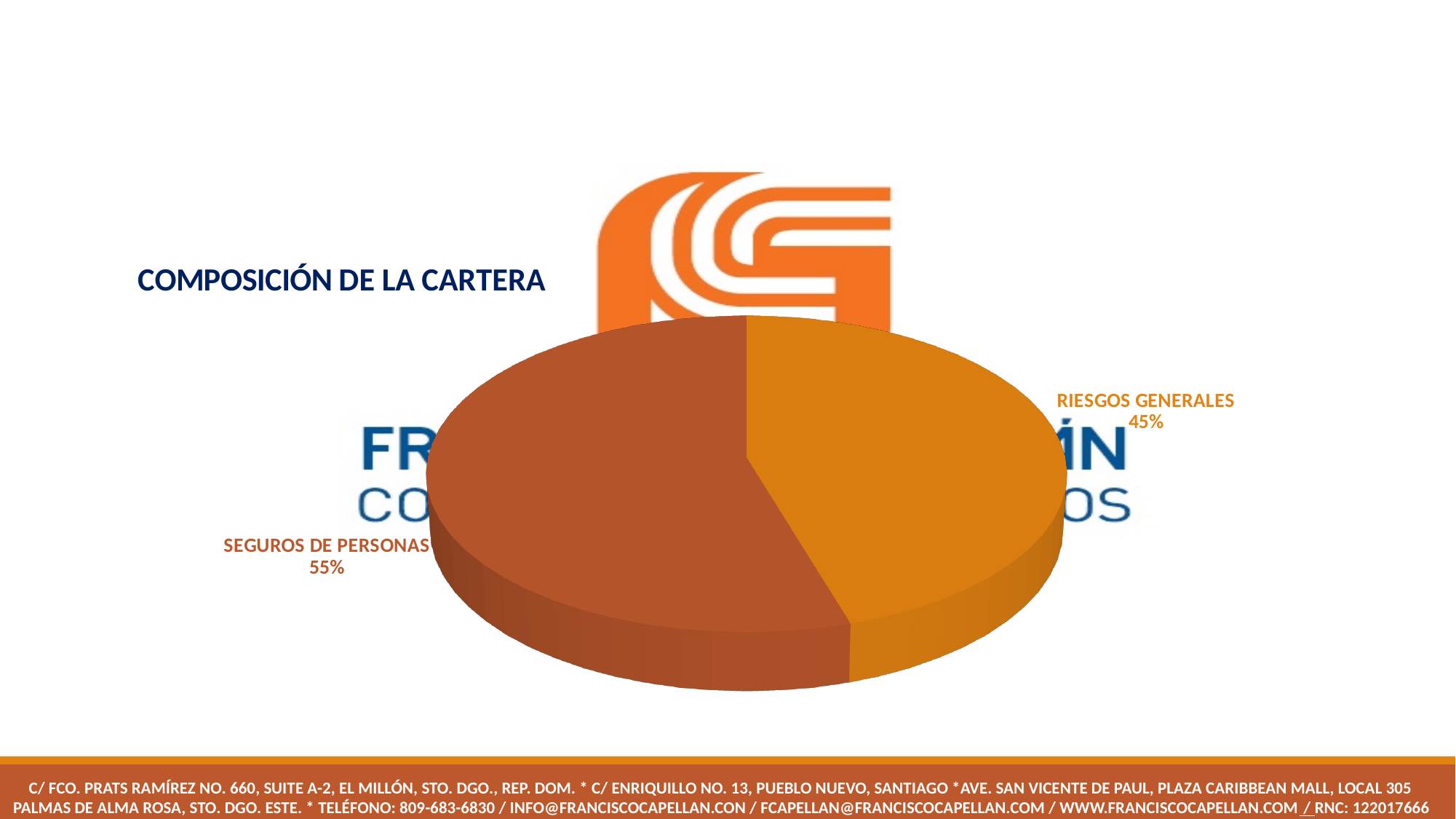
What share of the pie does RIESGOS GENERALES represent? 45% Is the share for RIESGOS GENERALES greater or less than 50%? less How many categories are shown in the pie chart? 2 What is the title of the chart? COMPOSICIÓN DE LA CARTERA Which category has the smallest share of the pie? RIESGOS GENERALES What share of the pie does SEGUROS DE PERSONAS represent? 55% Which category has the largest share of the pie? SEGUROS DE PERSONAS What is the total of the two slices shown in the pie chart? 100% Which is larger, SEGUROS DE PERSONAS or RIESGOS GENERALES? SEGUROS DE PERSONAS What kind of chart is shown on the slide? Pie chart What is the difference in percentage points between SEGUROS DE PERSONAS and RIESGOS GENERALES? 10 percentage points